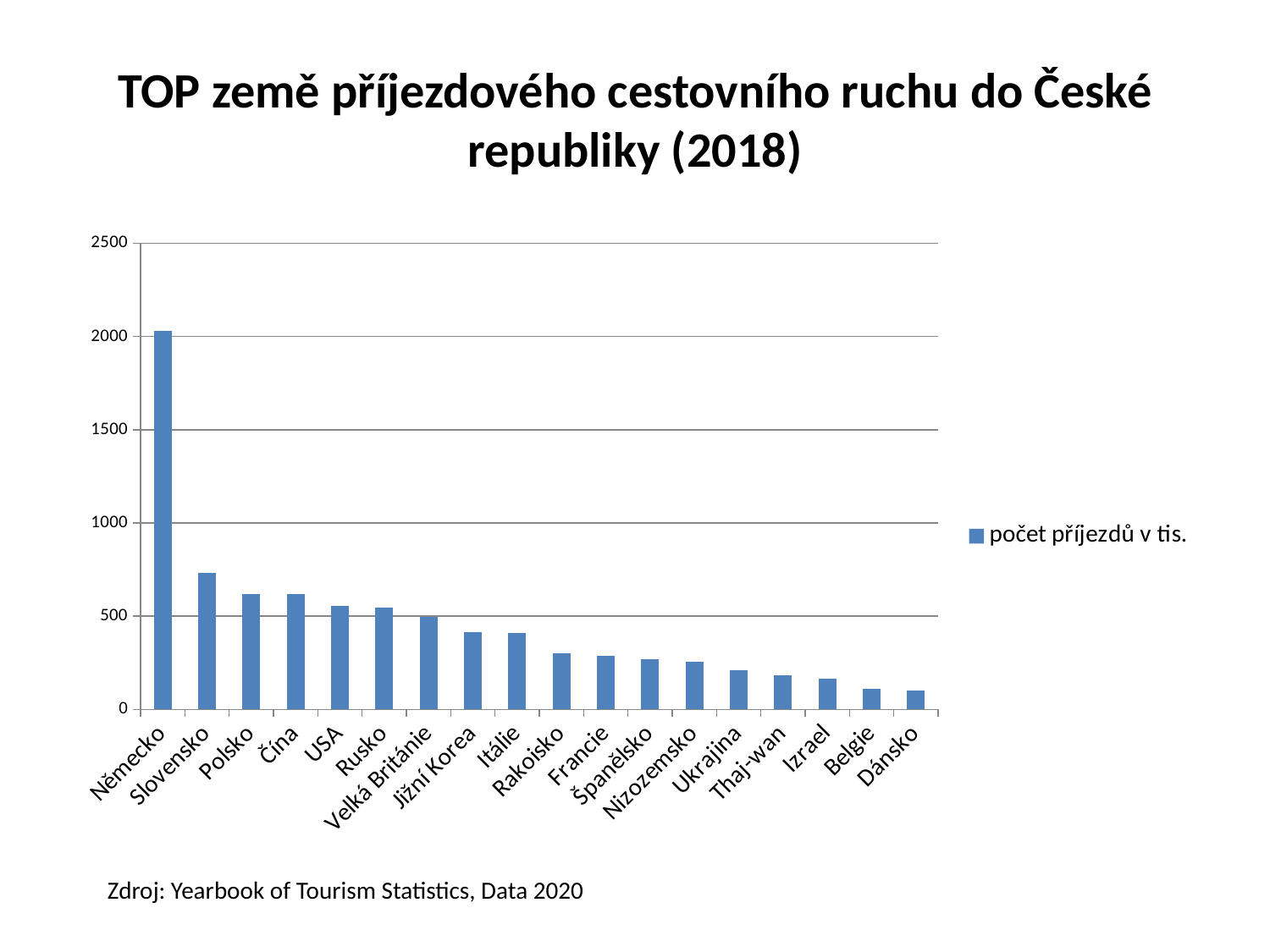
How many series does the legend list? 1 Is the value for Dánsko greater or less than 500? less Which has a larger value, Slovensko or Polsko? Slovensko Is the value for Slovensko greater or less than 500? greater What is the legend entry of the series plotted in the chart? počet příjezdů v tis. What kind of chart is shown on the slide? bar chart Do the values rise or fall moving from left to right along the x axis? fall Which country has the highest number of arrivals in the chart? Německo Which has a larger value, Německo or Slovensko? Německo Is the value for Německo greater or less than 1500? greater How many countries are shown on the x axis of the chart? 18